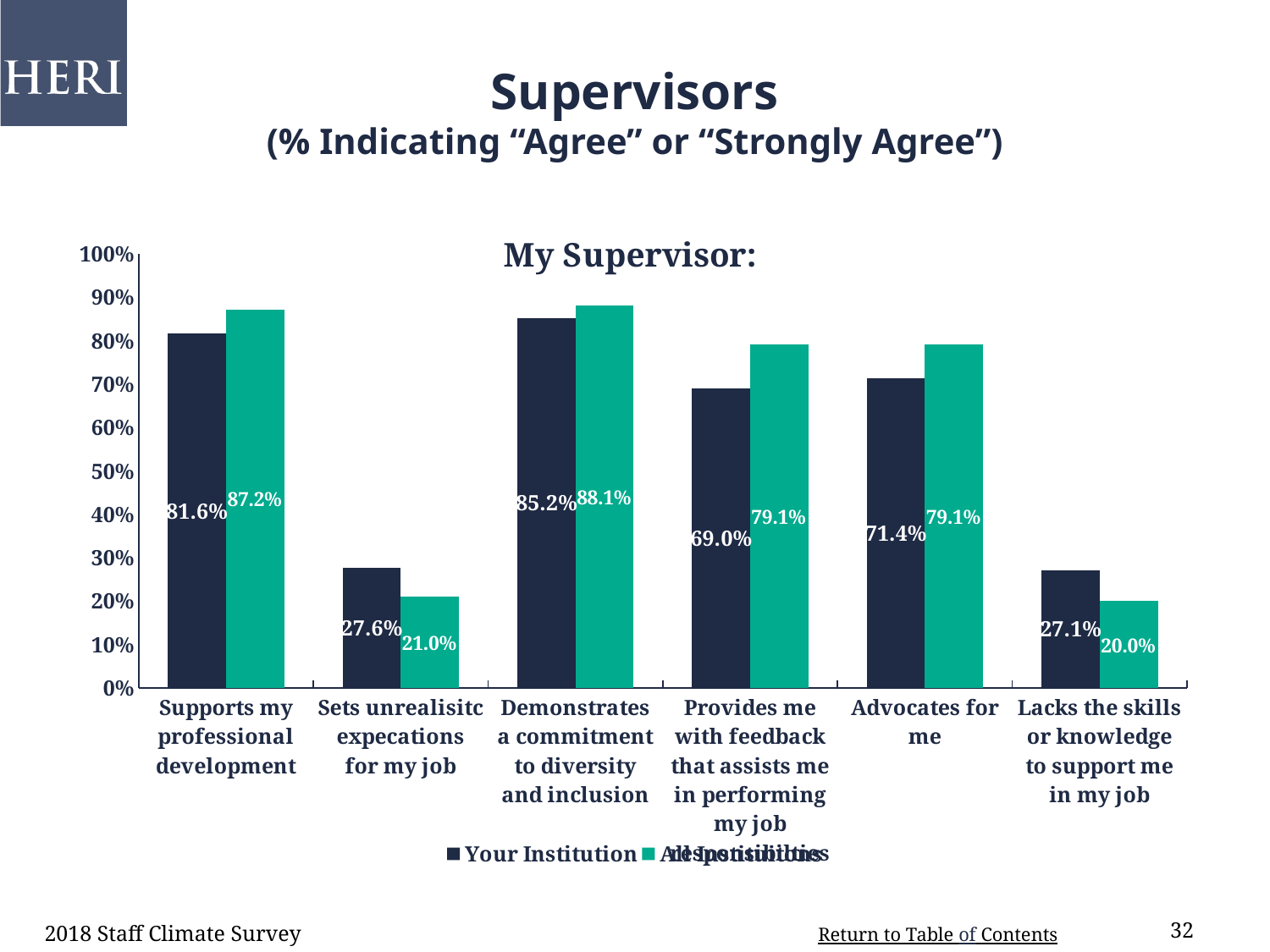
What is the value for "All Institutions" in the "Demonstrates a commitment to diversity and inclusion" category? 88.1% Which category has the lowest value for "All Institutions"? Lacks the skills or knowledge to support me in my job What kind of chart is shown on the slide? Bar chart What is the value for "Your Institution" in the "Advocates for me" category? 71.4% Is the "Your Institution" value for "Lacks the skills or knowledge to support me in my job" greater or less than 30%? less How many categories are shown on the x axis of the chart? 6 How many series does the legend list? 2 For "Sets unrealistic expectations for my job", which is larger: the "Your Institution" value or the "All Institutions" value? Your Institution What is the title of the chart? My Supervisor: What is the value for "Your Institution" in the "Supports my professional development" category? 81.6% What is the difference between the "All Institutions" and "Your Institution" values for "Provides me with feedback that assists me in performing my job responsibilities"? 10.1% Which category has the highest value for "Your Institution"? Demonstrates a commitment to diversity and inclusion